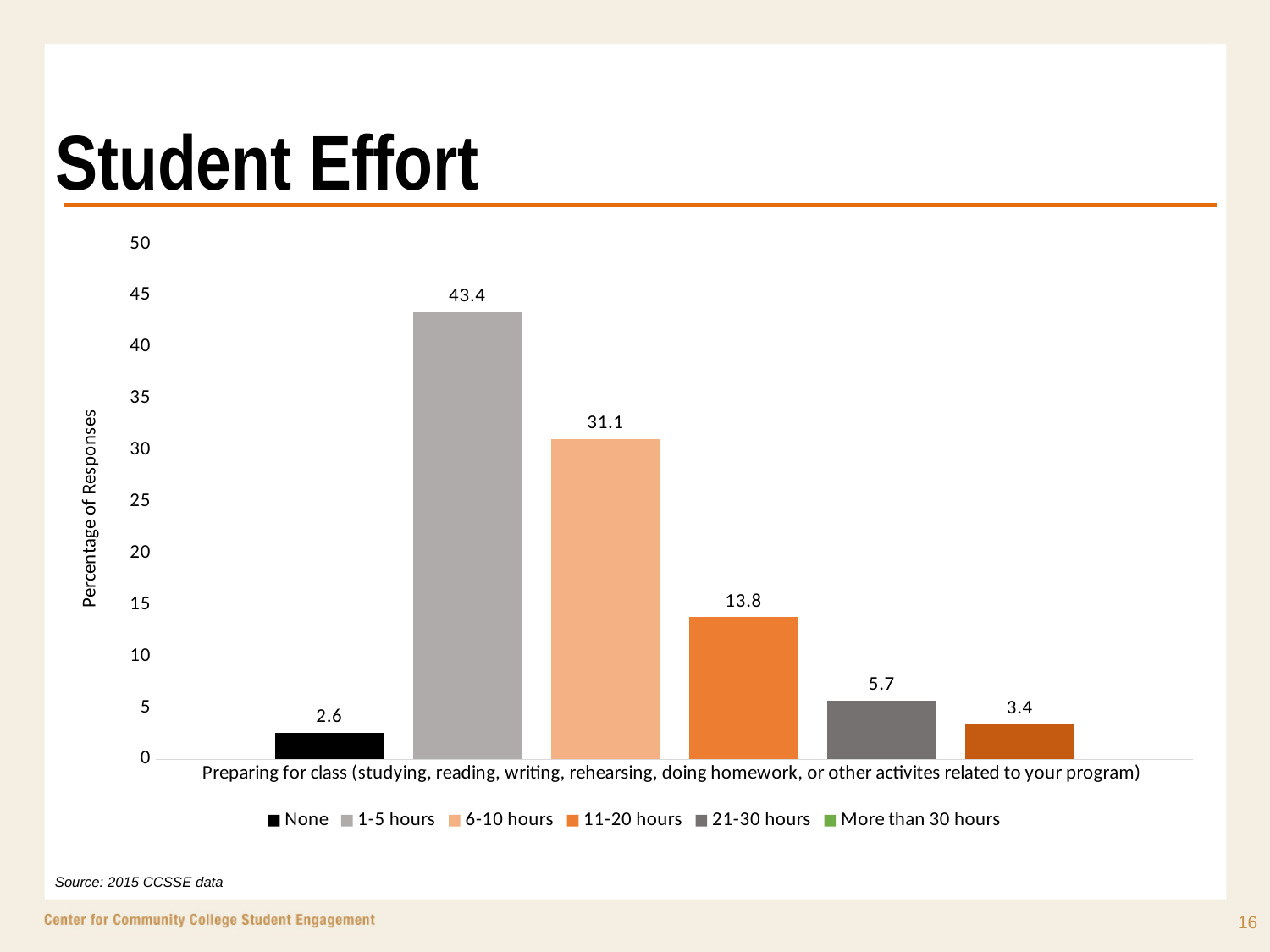
Which category has the highest value? 1-5 hours Which category has the lowest value? None What is the value for 21-30 hours? 5.7 What is the value for 1-5 hours? 43.4 Which is larger, the value for 21-30 hours or the value for More than 30 hours? 21-30 hours How many series does the legend list? 6 What is the value for None? 2.6 What is the difference between the values for 1-5 hours and 6-10 hours? 12.3 What is the label of the vertical axis? Percentage of Responses What is the value for 6-10 hours? 31.1 What kind of chart is shown on the slide? Bar chart What is the value for 11-20 hours? 13.8